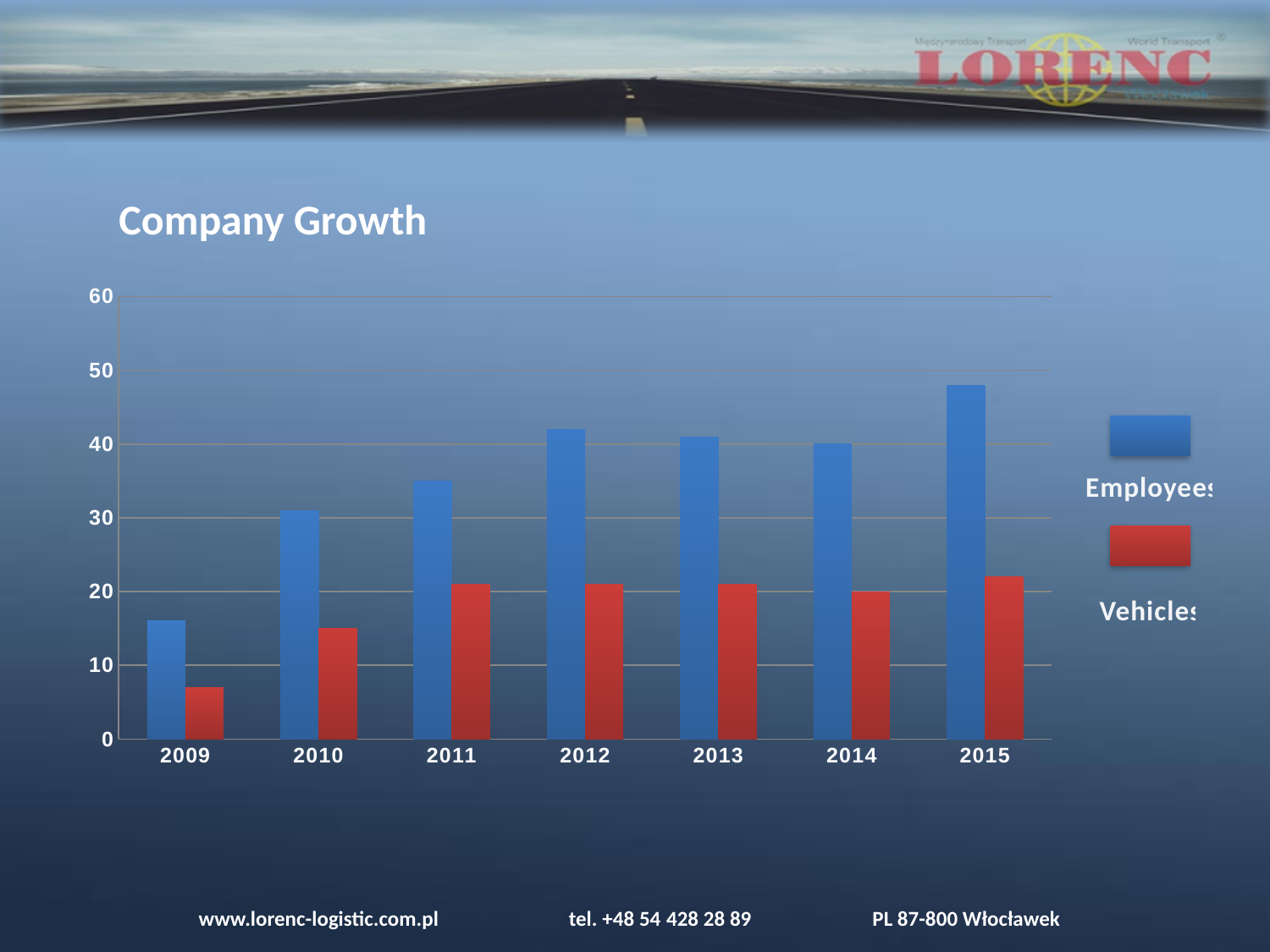
Which year has the highest number of Employees? 2015 Do the Employees values rise or fall from 2009 to 2011? rise Is the value for Employees in 2015 greater or less than 40? greater Is the value for Employees in 2009 greater or less than 20? less What is the title of the chart? Company Growth How many series does the legend list? 2 How many years are shown on the x axis of the chart? 7 What kind of chart is shown on the slide? bar chart Which year has the lowest number of Vehicles? 2009 Is the value for Vehicles in 2009 greater or less than 10? less Which year has the lowest number of Employees? 2009 Which is larger in 2015, Employees or Vehicles? Employees